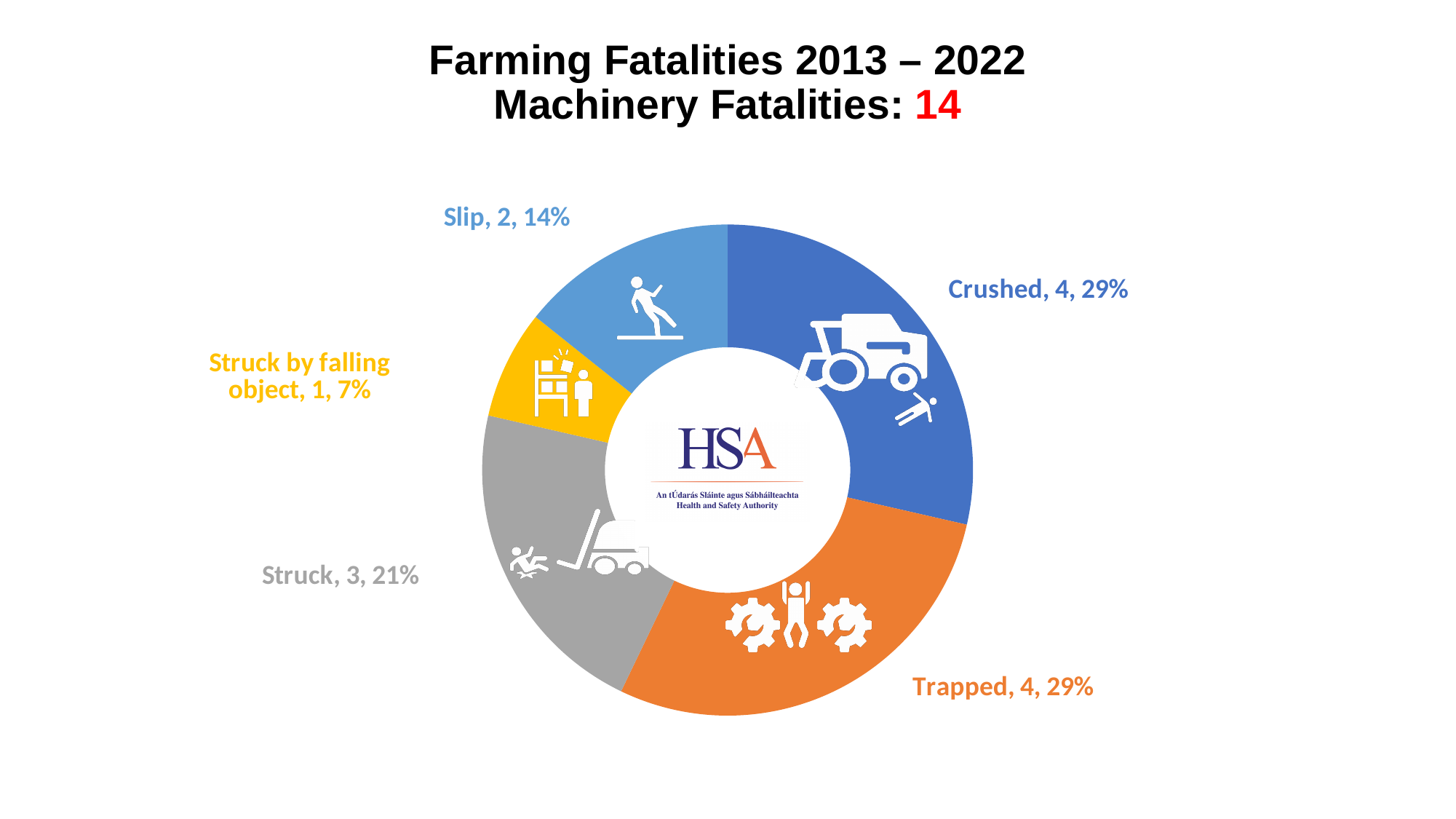
How many categories does the pie chart show? 5 What percentage of machinery fatalities is attributed to Slip? 14% What share of machinery fatalities is attributed to Struck by falling object? 7% What kind of chart is shown on the slide? Pie chart (doughnut) What is the difference between the number of Struck fatalities and Slip fatalities? 1 Which is larger, the number of Struck fatalities or the number of Slip fatalities? Struck What is the total number of machinery fatalities stated in the title? 14 Which category has the lowest number of fatalities? Struck by falling object How many machinery fatalities were due to being crushed? 4 How many fatalities are shown for Struck? 3 What share of machinery fatalities is attributed to Trapped? 29% What colour is the Trapped slice of the pie chart? Orange